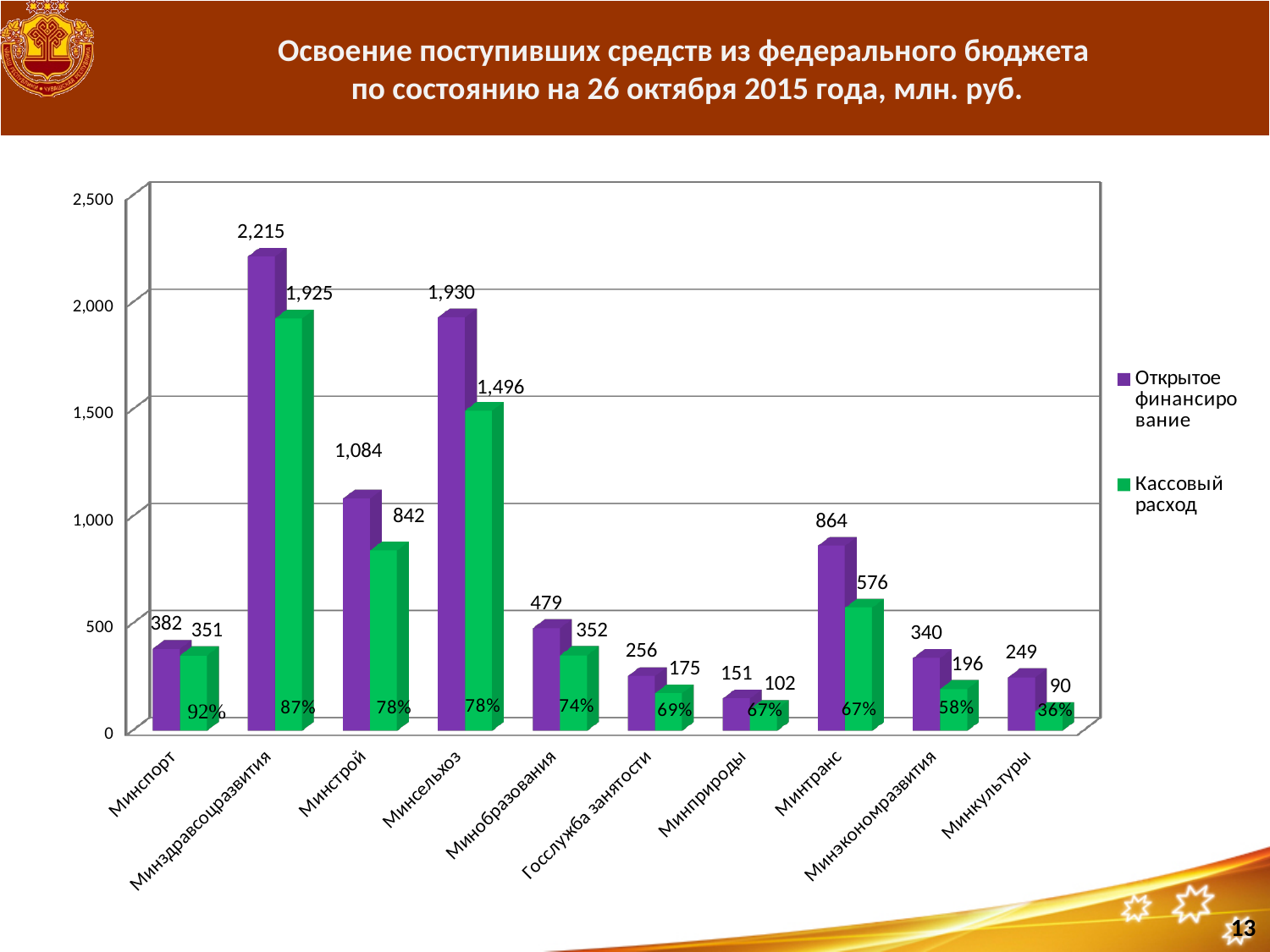
What kind of chart is shown on the slide? bar chart Which category has the lowest value of Кассовый расход? Минкультуры Is the value of Открытое финансирование for Минобразования greater or less than 500? less How many series does the legend list? 2 What is the difference between Открытое финансирование and Кассовый расход for Минтранс? 288 What is the value of Открытое финансирование for Минздравсоцразвития? 2,215 What is the value of Кассовый расход for Минкультуры? 90 How many categories are shown on the x axis? 10 What is the value of Кассовый расход for Минсельхоз? 1,496 Which category has the highest value of Открытое финансирование? Минздравсоцразвития What percentage is shown for Минприроды? 67% Which is larger: Кассовый расход for Минстрой or Кассовый расход for Минтранс? Минстрой